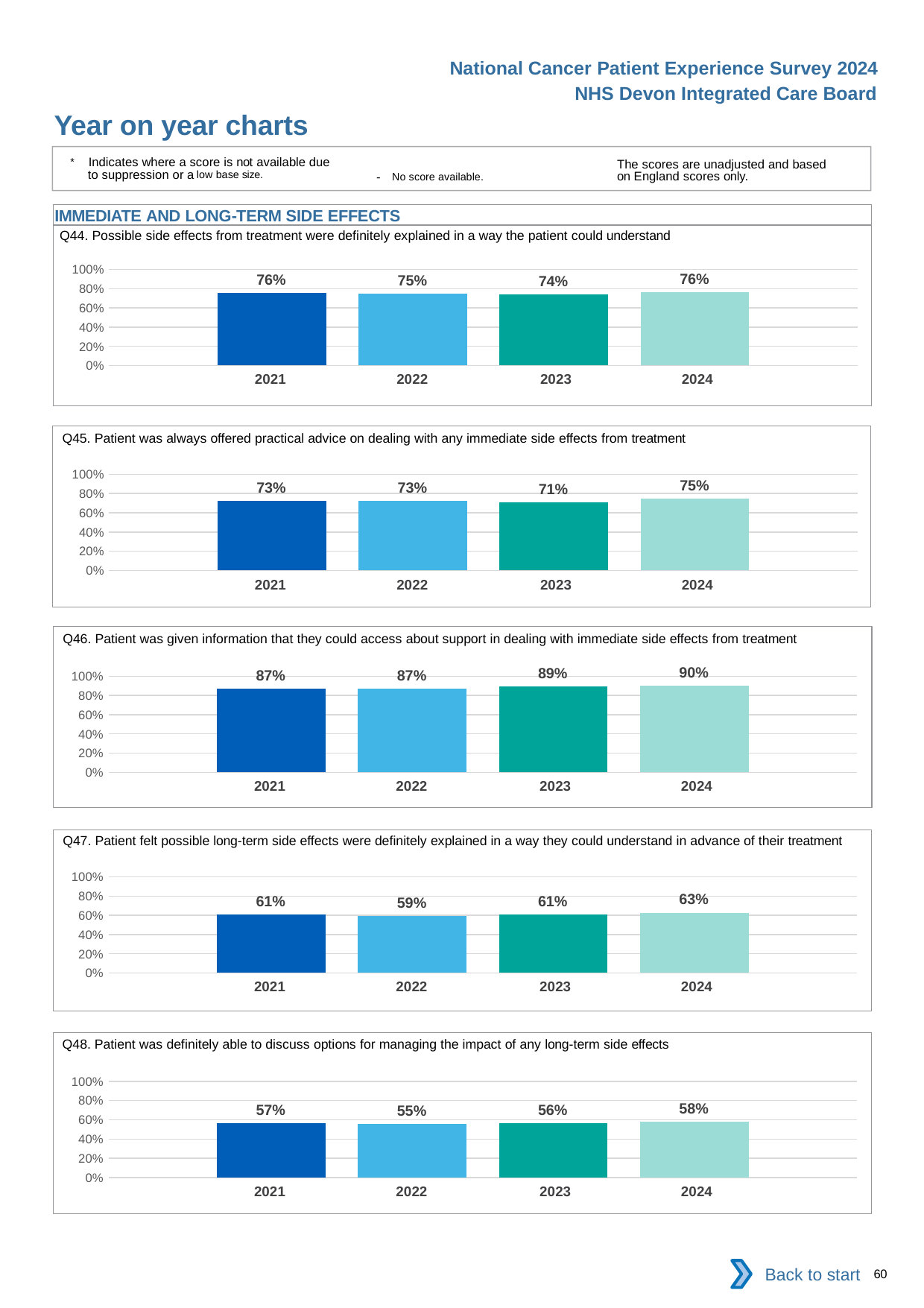
In the Q46 chart, which year has the highest value? 2024 In the Q47 chart, what is the difference between the 2021 value and the 2022 value? 2% In the Q47 chart, which is larger, the value for 2022 or the value for 2024? 2024 How many charts are shown on the slide? 5 In the Q48 chart, what is the value for 2024? 58% What kind of chart is the Q46 chart? bar chart In the Q45 chart, which year has the highest value? 2024 In the Q46 chart, what is the difference between the 2024 value and the 2021 value? 3% How many years are shown on the x axis of the Q44 chart? 4 In the Q45 chart, which year has the lowest value? 2023 In the Q48 chart, is the value for 2022 greater or less than 60%? less In the Q44 chart, what is the value for 2023? 74%